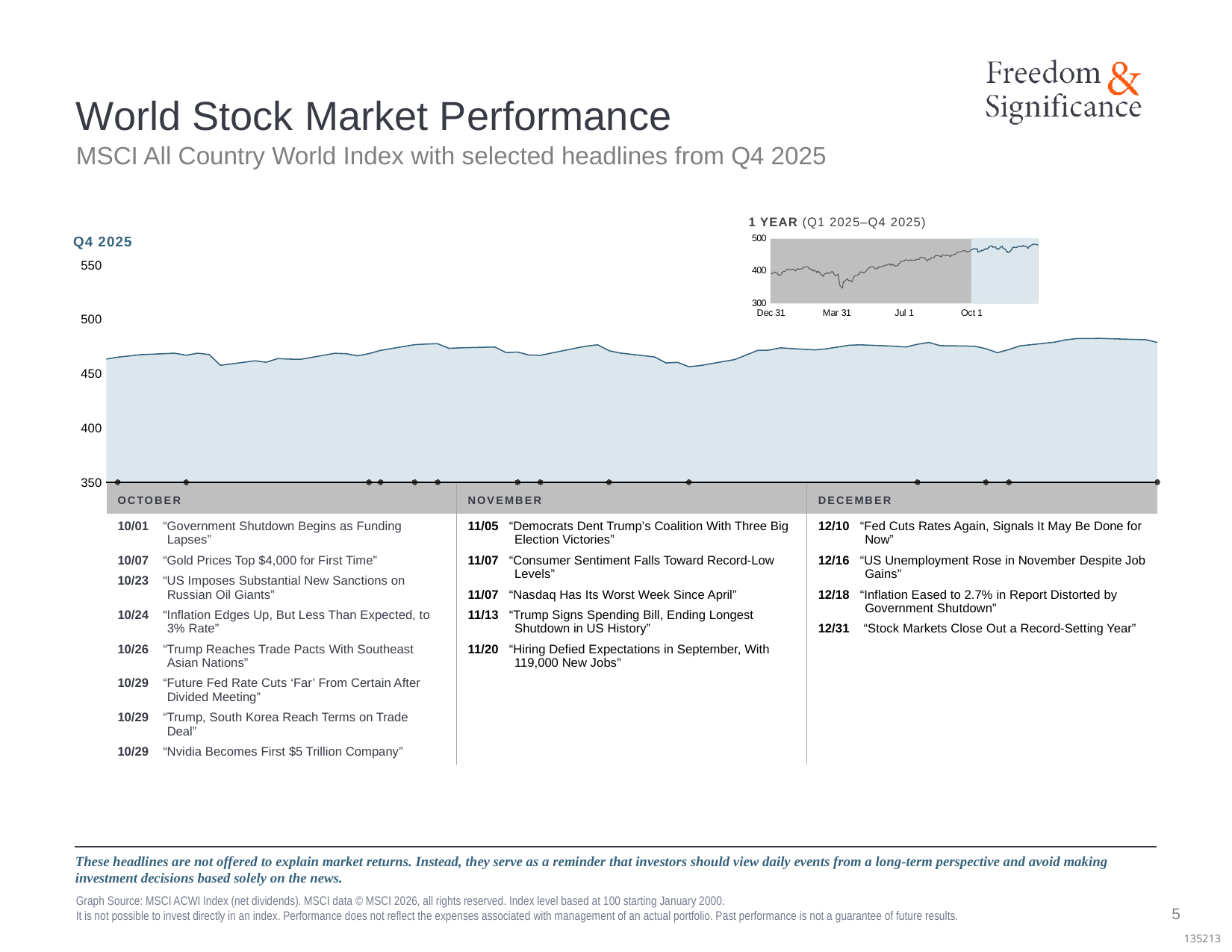
What is the highest value shown on the y axis of the Q4 2025 chart? 550 What period does the 1 YEAR inset chart cover, according to its title? Q1 2025–Q4 2025 How many date labels are shown on the x axis of the 1 YEAR inset chart? 4 Which months are labelled along the x axis of the Q4 2025 chart? October, November, December What kind of chart is the Q4 2025 chart on the slide? area chart On the Q4 2025 chart, is the index value at the start of October greater or less than 450? greater On the Q4 2025 chart, is the index value at the end of December greater or less than 500? less On the 1 YEAR inset chart, does the index rise or fall from Dec 31 to the end of the period? rise On the Q4 2025 chart, is the index value in mid-November greater or less than 400? greater How many months are labelled along the x axis of the Q4 2025 chart? 3